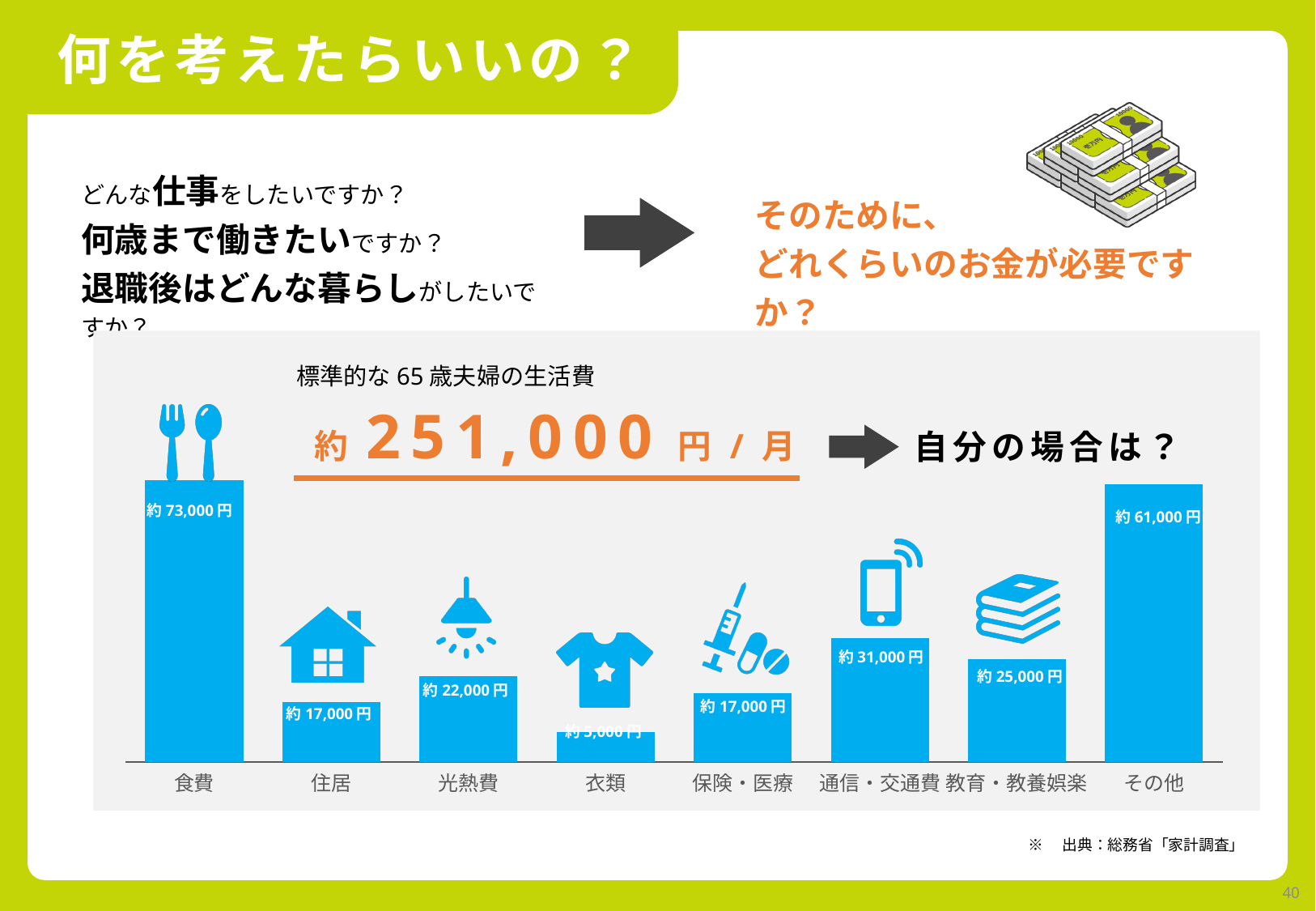
Which category has the lowest value? 衣類 What is the value shown for その他? 約 61,000 円 Which category has the highest value? 食費 What is the value shown for 光熱費? 約 22,000 円 How many categories are shown in the chart? 8 What kind of chart is shown on the slide? bar chart What is the value shown for 教育・教養娯楽? 約 25,000 円 What is the difference between the values for 食費 and その他? 12,000 円 What is the value shown for 通信・交通費? 約 31,000 円 What is the value shown for 食費? 約 73,000 円 Which is larger, 通信・交通費 or 教育・教養娯楽? 通信・交通費 What monthly total is printed above the chart for a standard 65-year-old couple's living expenses? 約 251,000 円 / 月